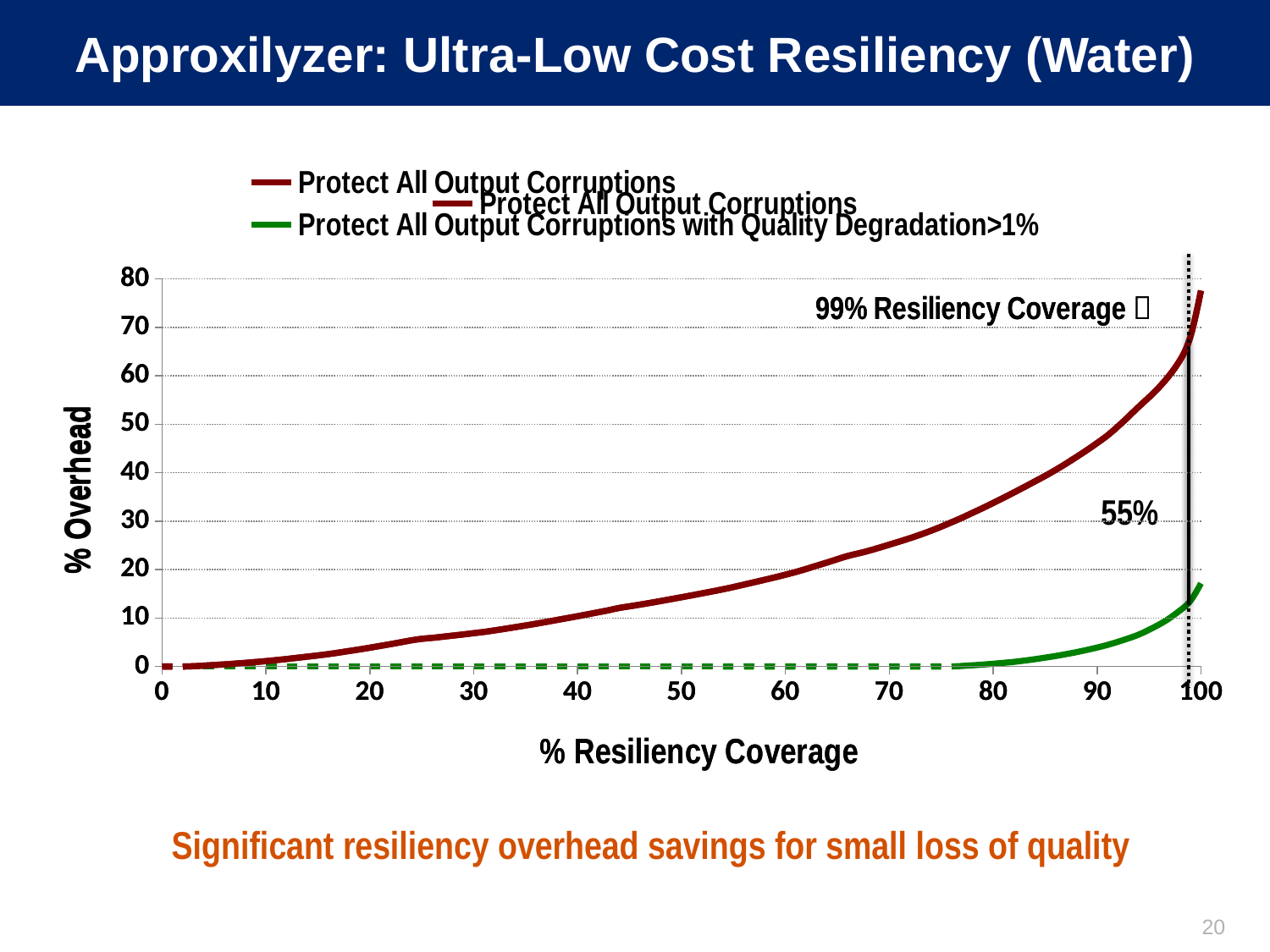
Is the % Overhead for Protect All Output Corruptions at 100% Resiliency Coverage greater or less than 70? greater Which series is drawn in green? Protect All Output Corruptions with Quality Degradation>1% Is the % Overhead for Protect All Output Corruptions at 90% Resiliency Coverage greater or less than 40? greater Is the % Overhead for Protect All Output Corruptions with Quality Degradation>1% at 90% Resiliency Coverage greater or less than 10? less Which series has the lower % Overhead across the whole range of % Resiliency Coverage? Protect All Output Corruptions with Quality Degradation>1% Does the % Overhead for Protect All Output Corruptions rise or fall as % Resiliency Coverage increases? rise What kind of chart is shown on the slide? line chart What is the label of the y axis? % Overhead At 90% Resiliency Coverage, which series has the higher % Overhead? Protect All Output Corruptions